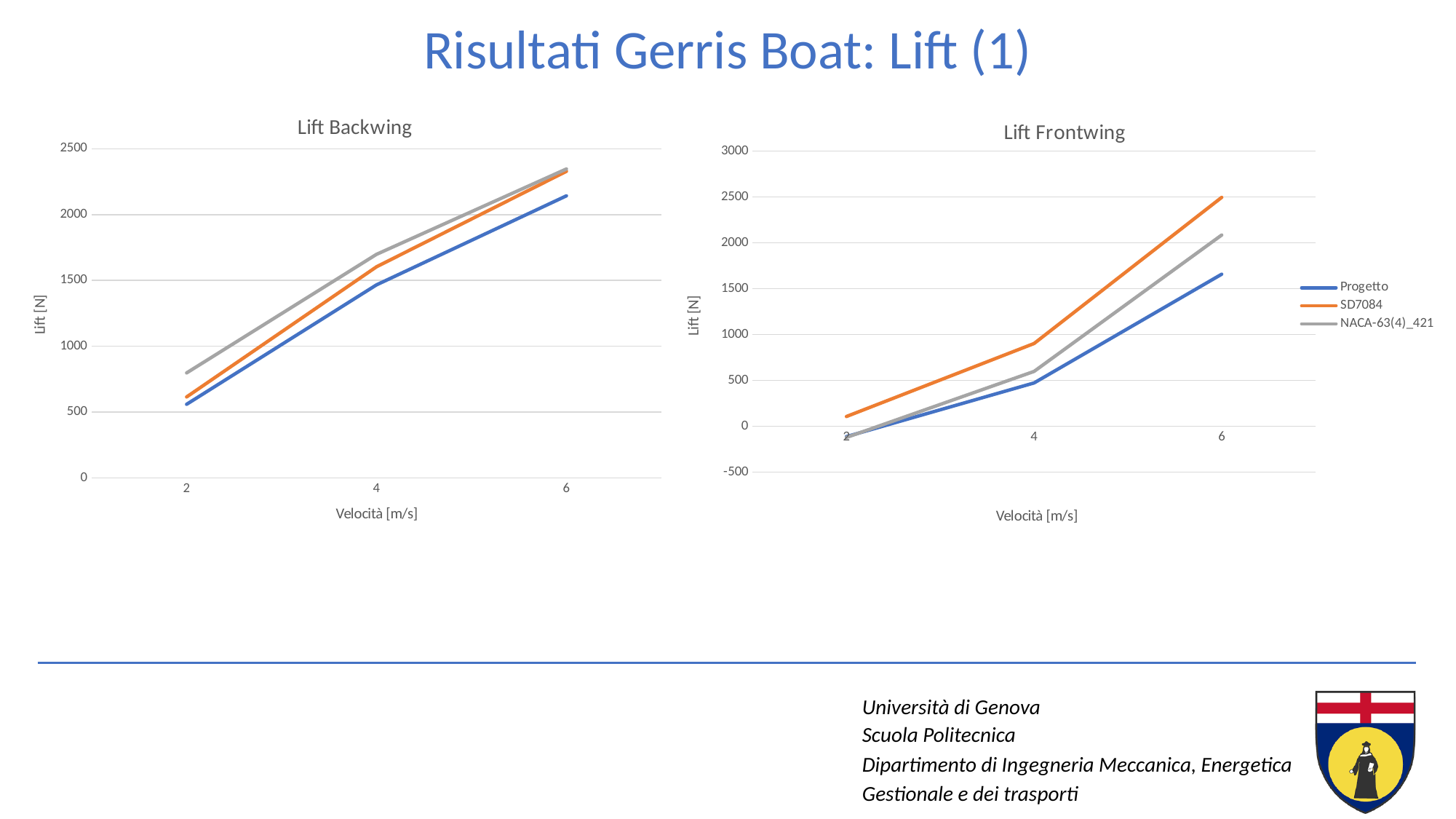
In the Lift Backwing chart, is the value of the blue line at 6 m/s greater or less than 2000? greater In the Lift Frontwing chart, at a velocity of 4 m/s, which is larger: SD7084 or Progetto? SD7084 In the Lift Backwing chart, is the value of the grey line at 2 m/s greater or less than 500? greater In the Lift Frontwing chart, which series has the lowest lift at a velocity of 6 m/s? Progetto In the Lift Frontwing chart, is the value for Progetto at 2 m/s greater or less than 0? less What type of chart is the Lift Backwing chart? line chart How many series does the legend of the Lift Frontwing chart list? 3 In the Lift Frontwing chart, which series has the highest lift at a velocity of 6 m/s? SD7084 How many velocity points are plotted along the x axis of the Lift Frontwing chart? 3 In the Lift Frontwing chart, does the lift for Progetto rise or fall as velocity increases? rise What is the label of the y axis on the Lift Backwing chart? Lift [N]